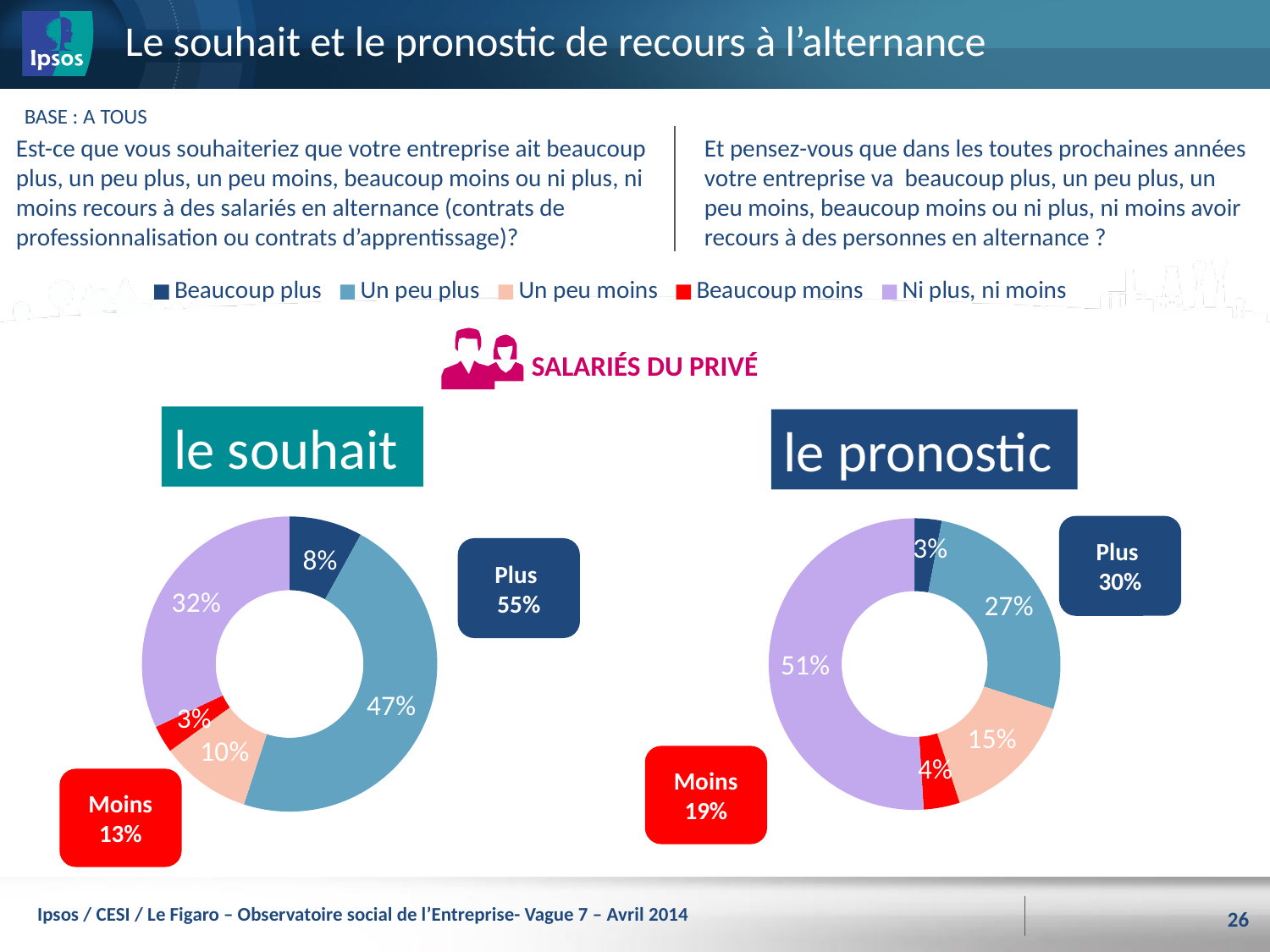
Which is larger: "Un peu plus" in the "le souhait" chart or "Un peu plus" in the "le pronostic" chart? le souhait In the "le pronostic" chart, what is the combined share of "Beaucoup plus" and "Un peu plus"? 30% In the "le souhait" chart, what is the value for "Un peu plus"? 47% What kind of chart is used for "le souhait"? Doughnut chart What is the difference between the "Ni plus, ni moins" values in the "le pronostic" chart and the "le souhait" chart? 19 percentage points In the "le souhait" chart, which category has the largest share? Un peu plus In the "le souhait" chart, what is the value for "Ni plus, ni moins"? 32% In the "le pronostic" chart, which category has the smallest share? Beaucoup plus In the "le souhait" chart, which category has the smallest share? Beaucoup moins In the "le pronostic" chart, what is the value for "Ni plus, ni moins"? 51% In the "le pronostic" chart, what is the value for "Un peu moins"? 15% How many categories does the legend list? 5